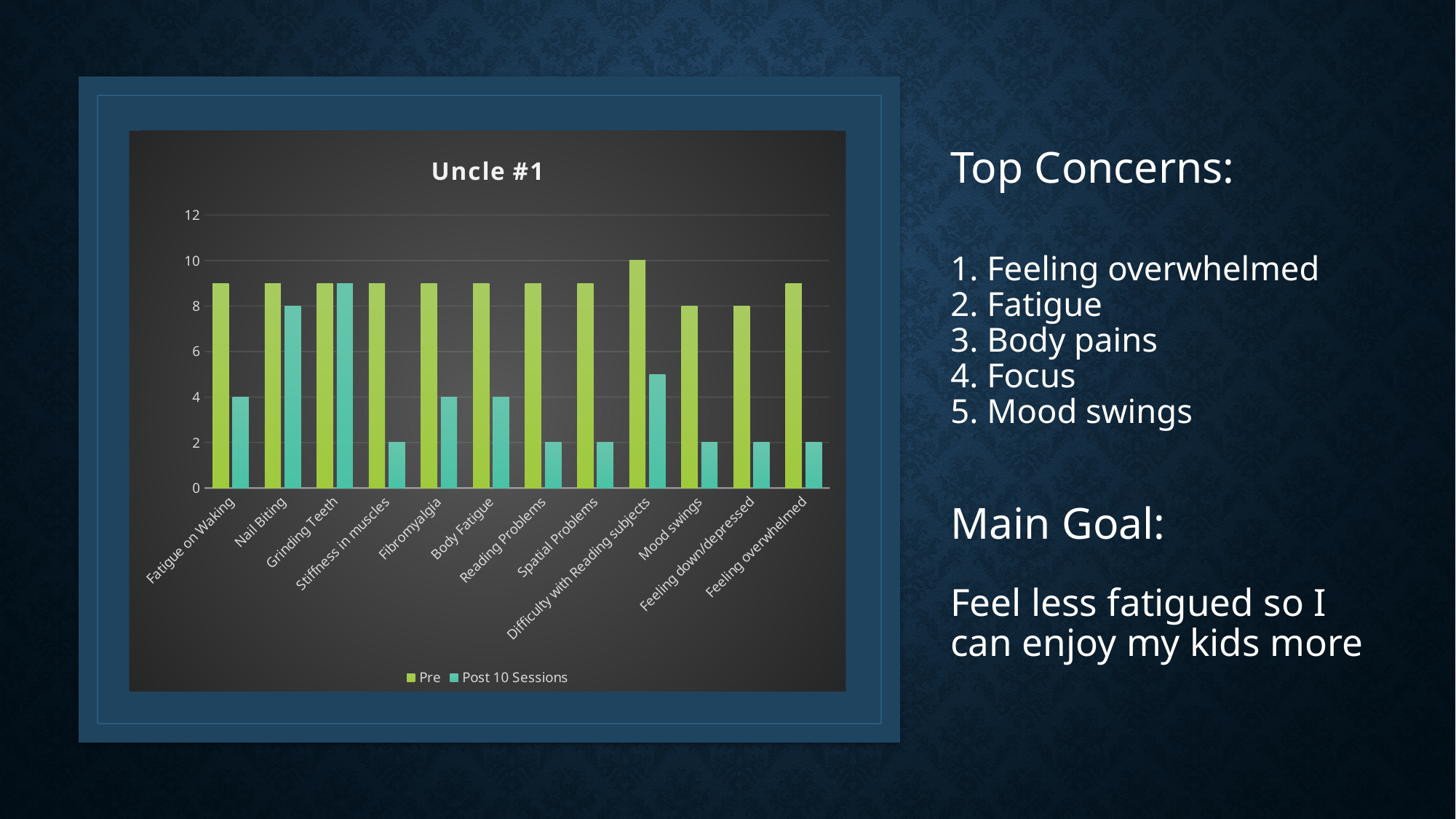
What is the Pre value for Difficulty with Reading subjects? 10 Which is larger: the Post 10 Sessions value for Nail Biting or for Fibromyalgia? Nail Biting Which category has the highest Pre value? Difficulty with Reading subjects What is the Post 10 Sessions value for Mood swings? 2 What kind of chart is shown on the slide? bar chart What is the difference between the Pre and Post 10 Sessions values for Mood swings? 6 Which category has the highest Post 10 Sessions value? Grinding Teeth How many categories are shown along the x axis of the chart? 12 How many series does the chart legend list? 2 What is the Post 10 Sessions value for Fatigue on Waking? 4 Is the Post 10 Sessions value for Difficulty with Reading subjects greater or less than 4? greater What is the title of the chart? Uncle #1